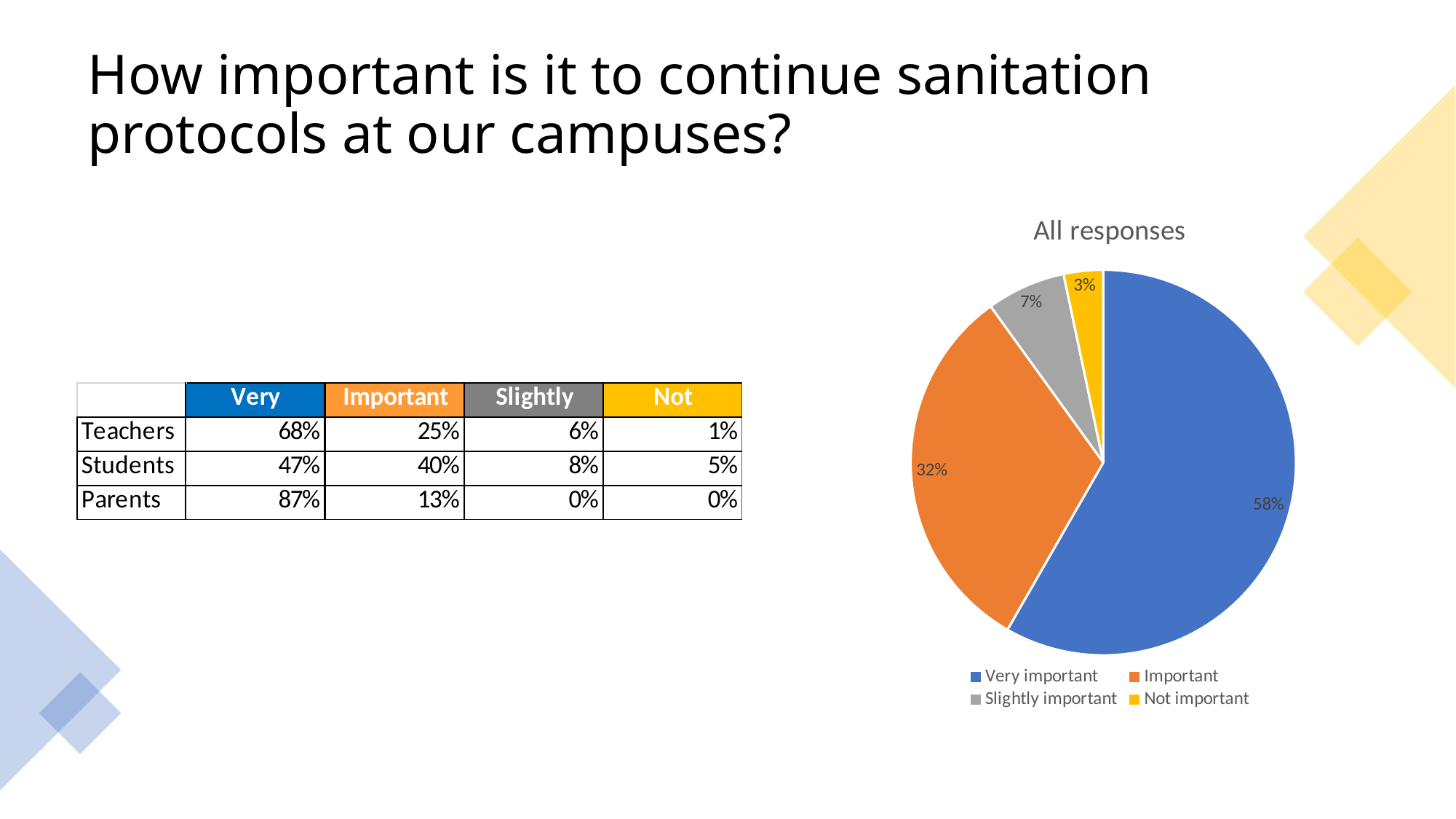
Which response category has the smallest slice of the pie? Not important What share of all responses is 'Not important'? 3% What is the difference in percentage points between the 'Very important' and 'Important' slices? 26 What colour is the 'Important' slice in the pie chart? orange Which response category has the largest slice of the pie? Very important What share of all responses is 'Slightly important'? 7% What type of chart is shown on the slide? pie chart What share of all responses is 'Important'? 32% How many slices does the pie chart have? 4 What is the title of the chart? All responses Which slice is larger, 'Slightly important' or 'Not important'? Slightly important What share of all responses is 'Very important'? 58%